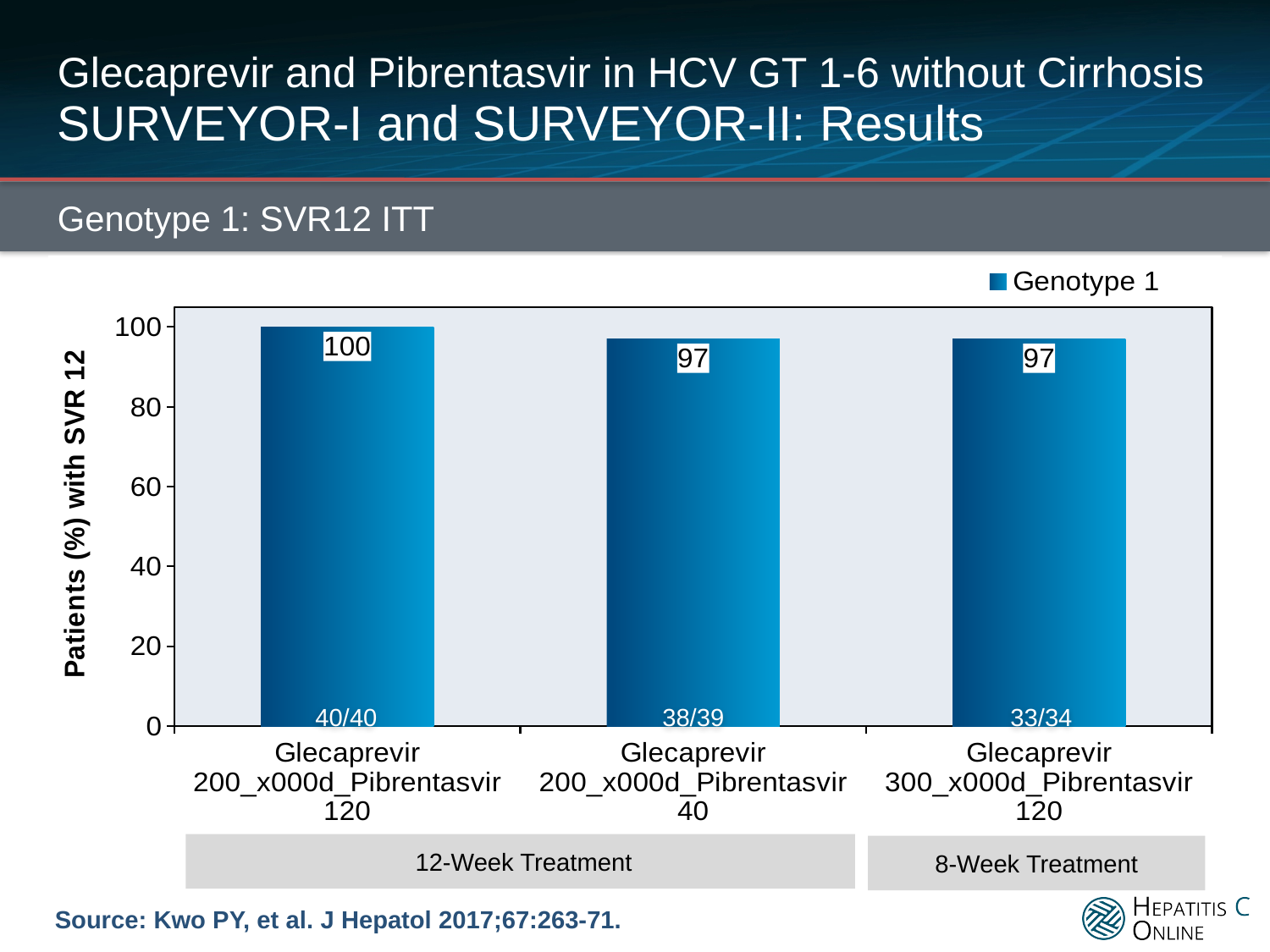
What is the SVR12 value for Glecaprevir 200 / Pibrentasvir 120 in the 12-Week Treatment group? 100 How many series does the legend list? 1 What kind of chart is shown on the slide? Bar chart What is the label of the y-axis? Patients (%) with SVR 12 How many treatment arms (bars) are shown in the chart? 3 What is the difference in SVR12 between Glecaprevir 200 / Pibrentasvir 120 (12-Week) and Glecaprevir 200 / Pibrentasvir 40 (12-Week)? 3 What is the SVR12 value for Glecaprevir 200 / Pibrentasvir 40 in the 12-Week Treatment group? 97 What patient fraction is shown at the base of the Glecaprevir 200 / Pibrentasvir 120 (12-Week Treatment) bar? 40/40 Which is larger: the SVR12 value for Glecaprevir 200 / Pibrentasvir 120 (12-Week) or for Glecaprevir 300 / Pibrentasvir 120 (8-Week)? Glecaprevir 200 / Pibrentasvir 120 (12-Week) What patient fraction is shown at the base of the Glecaprevir 300 / Pibrentasvir 120 (8-Week Treatment) bar? 33/34 What is the SVR12 value for Glecaprevir 300 / Pibrentasvir 120 in the 8-Week Treatment group? 97 Which treatment arm has the highest SVR12 value? Glecaprevir 200 / Pibrentasvir 120 (12-Week Treatment)